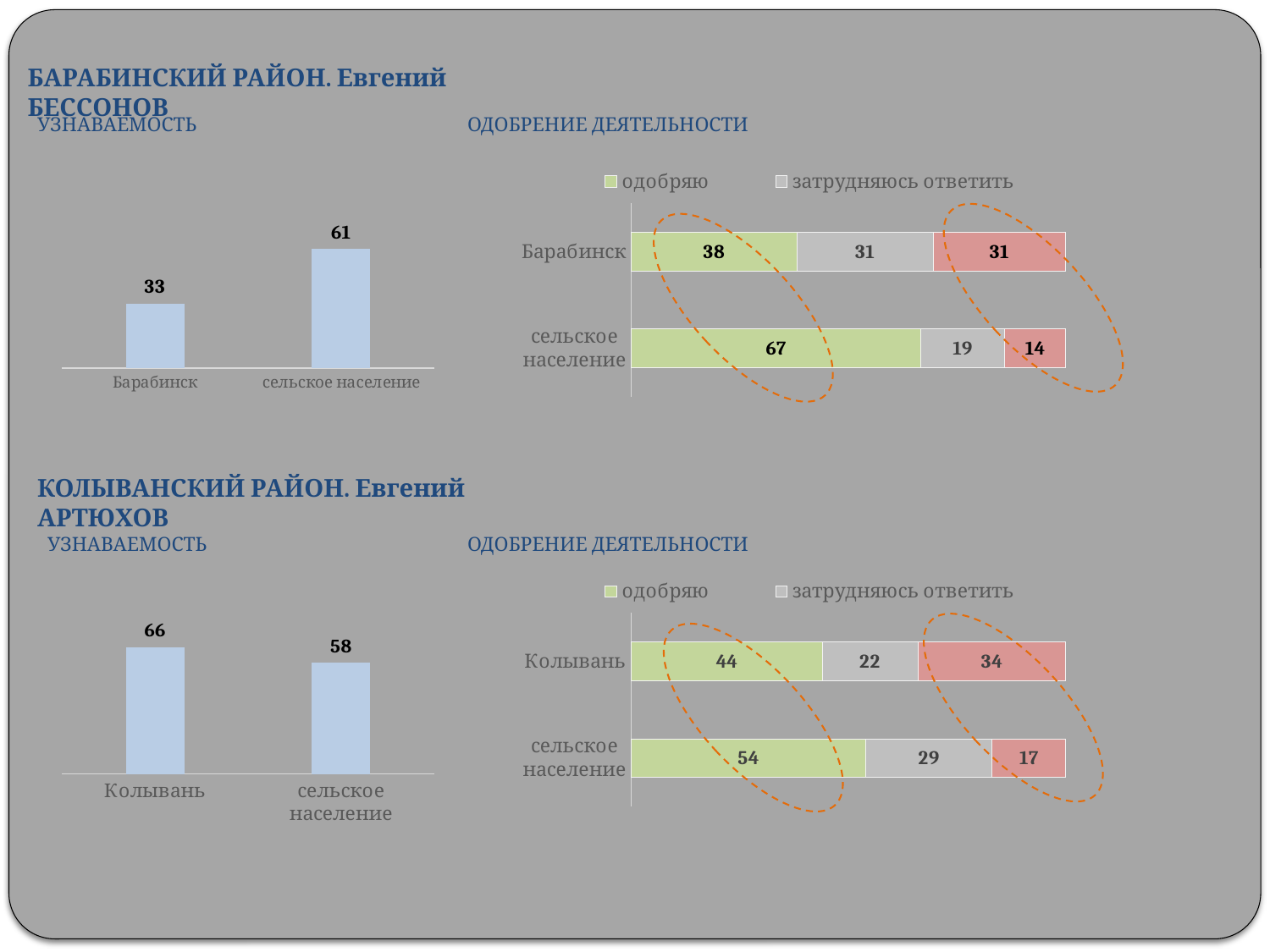
In the bottom-left УЗНАВАЕМОСТЬ chart (Колыванский район), what is the value for сельское население? 58 In the bottom-right ОДОБРЕНИЕ ДЕЯТЕЛЬНОСТИ chart (Колыванский район), what is the одобряю value for Колывань? 44 In the top-left УЗНАВАЕМОСТЬ chart (Барабинский район), what is the value for сельское население? 61 In the bottom-left УЗНАВАЕМОСТЬ chart (Колыванский район), which is larger: the value for Колывань or for сельское население? Колывань In the top-right ОДОБРЕНИЕ ДЕЯТЕЛЬНОСТИ chart (Барабинский район), what is the затрудняюсь ответить value for Барабинск? 31 In the top-left УЗНАВАЕМОСТЬ chart (Барабинский район), which category has the highest value? сельское население In the bottom-right ОДОБРЕНИЕ ДЕЯТЕЛЬНОСТИ chart (Колыванский район), how much higher is the одобряю value for сельское население than for Колывань? 10 In the top-left УЗНАВАЕМОСТЬ chart (Барабинский район), what is the value for Барабинск? 33 In the top-left УЗНАВАЕМОСТЬ chart (Барабинский район), what is the difference between the values for сельское население and Барабинск? 28 What kind of chart is the top-left УЗНАВАЕМОСТЬ chart (Барабинский район)? bar chart In the top-right ОДОБРЕНИЕ ДЕЯТЕЛЬНОСТИ chart (Барабинский район), what is the total of the stacked bar for Барабинск? 100 In the top-right ОДОБРЕНИЕ ДЕЯТЕЛЬНОСТИ chart (Барабинский район), what is the одобряю value for сельское население? 67